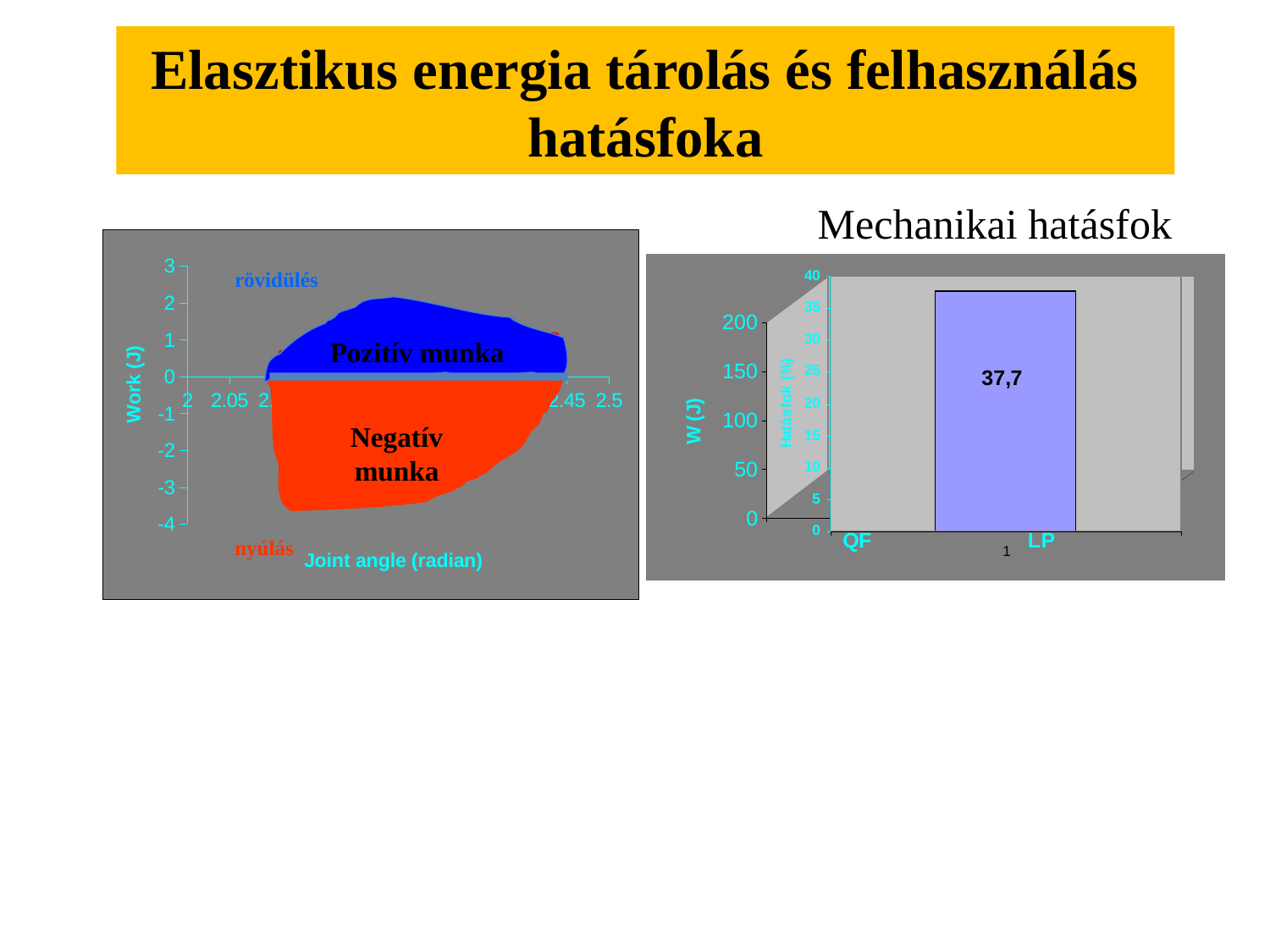
What is the lowest value shown on the y-axis of the chart on the left? -4 In the Mechanikai hatásfok chart on the right, what value is printed on the bar? 37,7 What is the x-axis label of the chart on the left? Joint angle (radian) What is the highest value shown on the y-axis of the chart on the left? 3 How many bars are plotted in the Mechanikai hatásfok chart on the right? 1 What kind of chart is the Mechanikai hatásfok chart on the right? bar chart In the Mechanikai hatásfok chart on the right, is the value of the bar greater or less than 35? greater In the chart on the left, what colour is the area labelled Pozitív munka? blue In the Mechanikai hatásfok chart on the right, is the value of the bar greater or less than 40? less